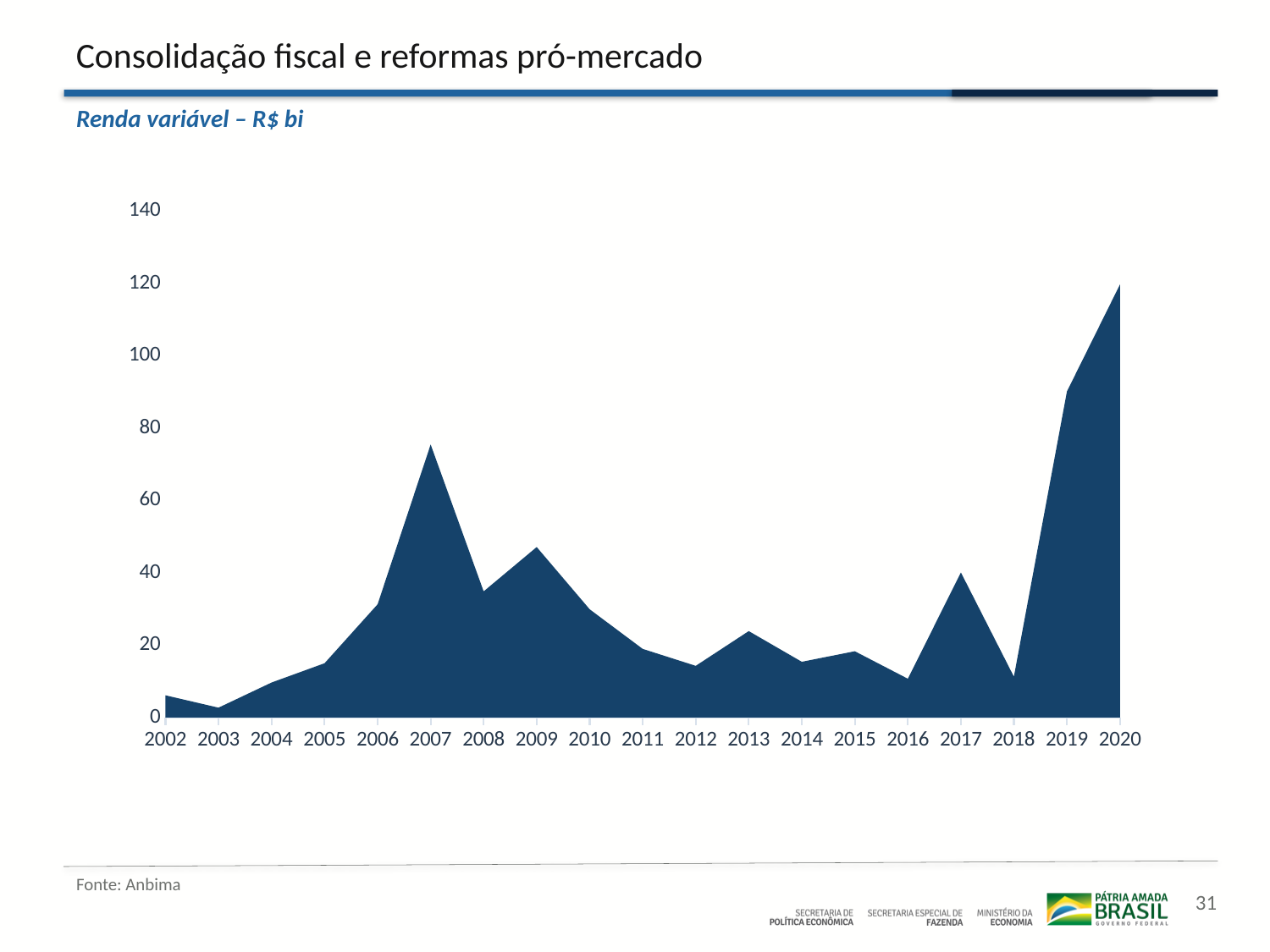
Which year has the lowest value in the chart? 2003 Is the value for 2007 greater or less than 60? greater Which year has the larger value, 2007 or 2009? 2007 What kind of chart is shown on the slide? area chart Do the values rise or fall from 2018 to 2020? rise Which year has the larger value, 2017 or 2016? 2017 How many years are plotted along the x axis of the chart? 19 Is the value for 2020 greater or less than 100? greater Which year has the highest value in the chart? 2020 What is the title of the chart? Renda variável – R$ bi Is the value for 2019 greater or less than 80? greater